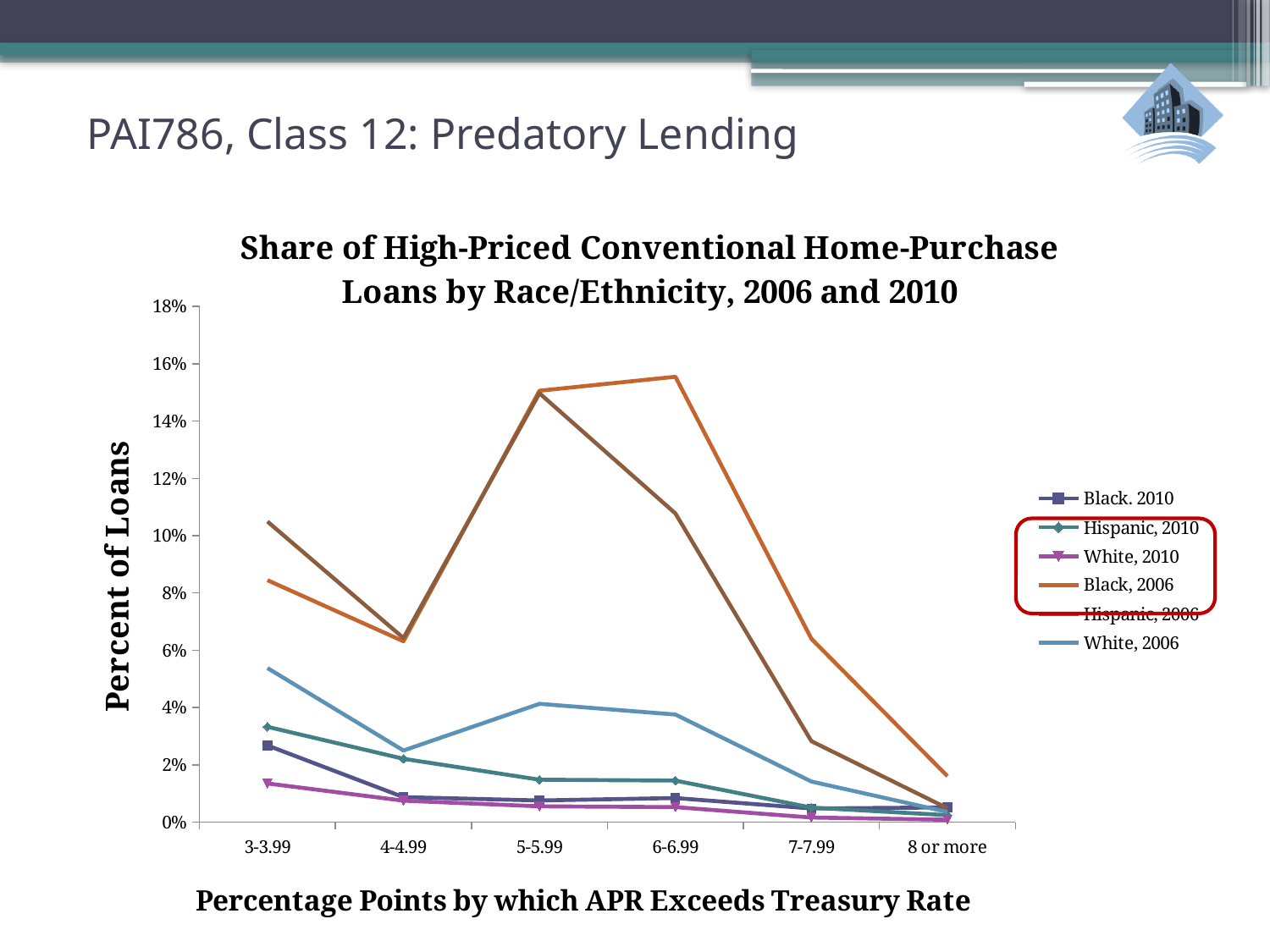
What kind of chart is shown on the slide? Line chart How many series does the legend list? 6 At 3-3.99, which series has the larger value: Black, 2006 or Hispanic, 2006? Hispanic, 2006 At which x-axis category does the Hispanic, 2006 series reach its highest value? 5-5.99 At which x-axis category does the Black, 2006 series reach its highest value? 6-6.99 How many categories are shown on the x axis? 6 At which x-axis category is the Black, 2006 series lowest? 8 or more Is the value for White, 2006 at 3-3.99 greater or less than 4%? greater Is the value for Hispanic, 2006 at 3-3.99 greater or less than 8%? greater Is the value for Black, 2006 at 6-6.99 greater or less than 14%? greater What is the label of the y axis? Percent of Loans